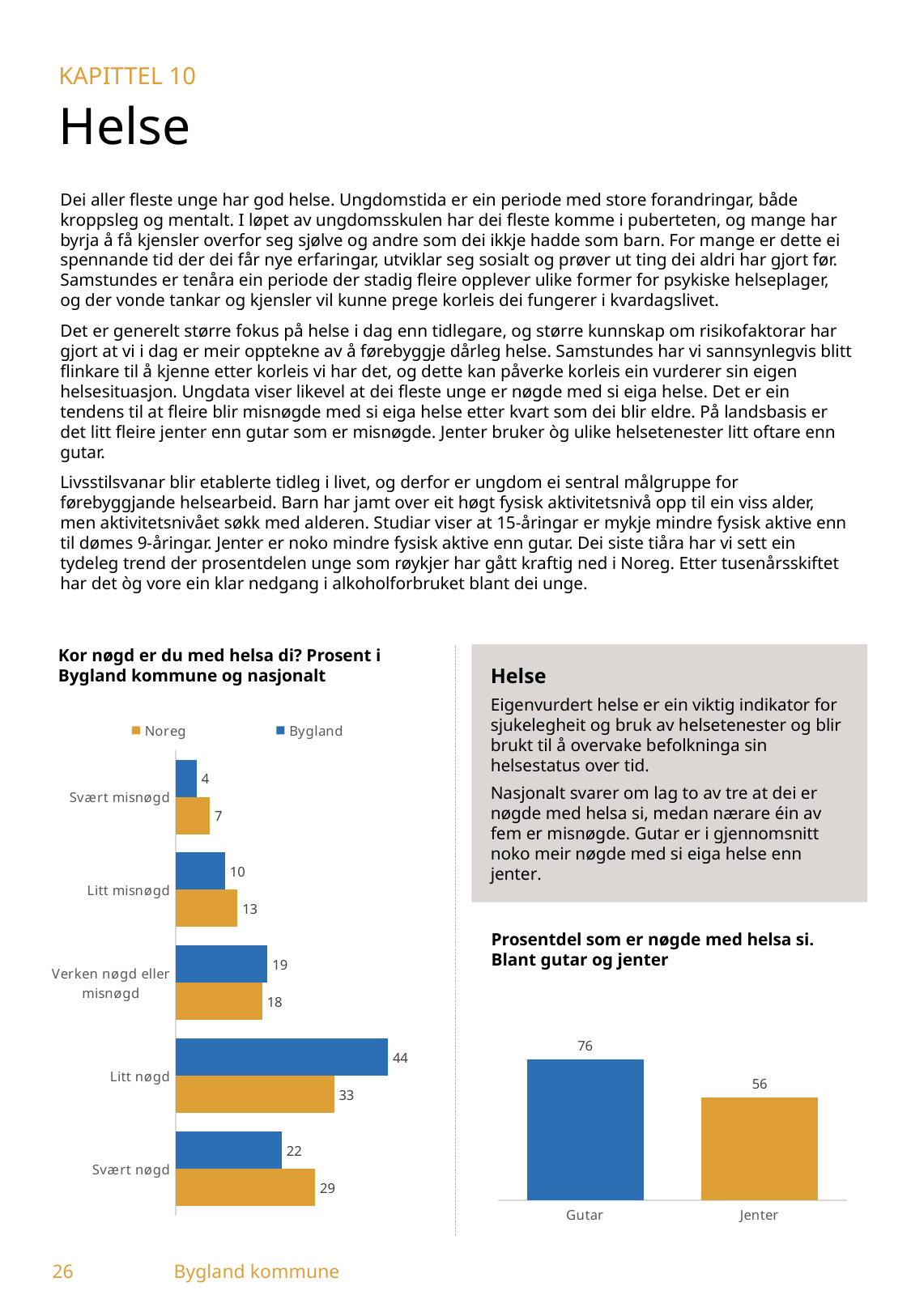
What kind of chart is 'Prosentdel som er nøgde med helsa si'? Bar chart In the chart 'Kor nøgd er du med helsa di?', what is the difference between Bygland and Noreg in the category 'Litt nøgd'? 11 In the chart 'Kor nøgd er du med helsa di?', what is the value for Noreg in the category 'Svært misnøgd'? 7 How many series does the legend list in the chart 'Kor nøgd er du med helsa di?'? 2 In the chart 'Kor nøgd er du med helsa di?', which category has the lowest value for Noreg? Svært misnøgd In the chart 'Prosentdel som er nøgde med helsa si', what is the difference between Gutar and Jenter? 20 In the chart 'Kor nøgd er du med helsa di?', which category has the highest value for Bygland? Litt nøgd In the chart 'Kor nøgd er du med helsa di?', which is larger for 'Svært nøgd': Bygland or Noreg? Noreg In the chart 'Kor nøgd er du med helsa di?', what is the value for Bygland in the category 'Litt nøgd'? 44 In the chart 'Prosentdel som er nøgde med helsa si', what is the value for Jenter? 56 How many categories are shown in the chart 'Kor nøgd er du med helsa di?'? 5 In the chart 'Kor nøgd er du med helsa di?', what is the value for Noreg in the category 'Svært nøgd'? 29